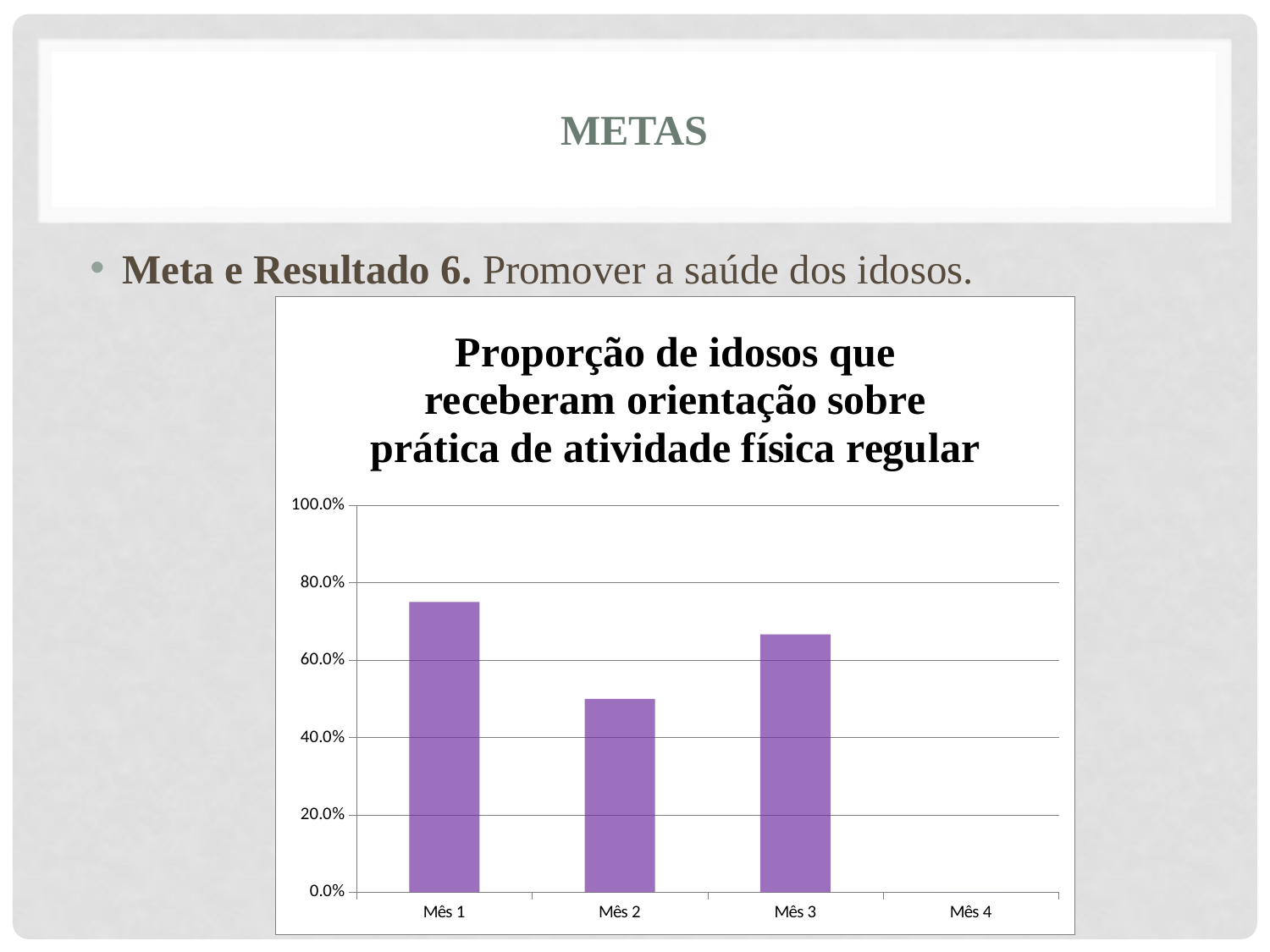
What is the title of the chart? Proporção de idosos que receberam orientação sobre prática de atividade física regular Is the value for Mês 3 greater or less than 60.0%? greater Is the value for Mês 1 greater or less than 80.0%? less Which is larger, the value for Mês 2 or the value for Mês 3? Mês 3 Which month has the lowest value in the chart? Mês 4 What kind of chart is shown on the slide? bar chart How many months (categories) are shown on the x axis of the chart? 4 Is the value for Mês 2 greater or less than 60.0%? less Does the value rise or fall from Mês 1 to Mês 2? fall Which is larger, the value for Mês 1 or the value for Mês 3? Mês 1 Which month has the highest value in the chart? Mês 1